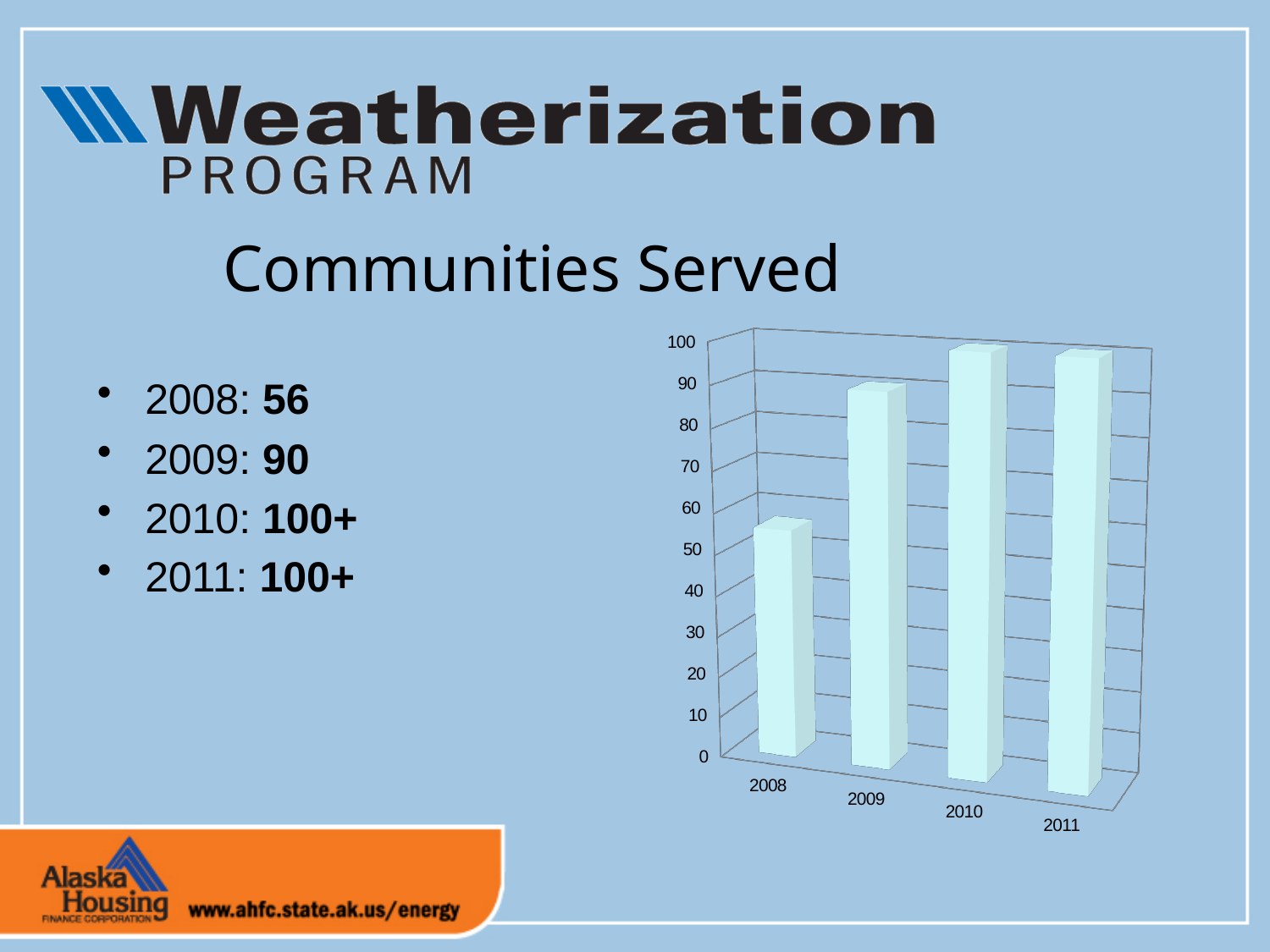
What kind of chart is shown on the slide? bar chart Is the value for 2011 greater or less than 90? greater Is the value for 2008 greater or less than 60? less How many years are plotted on the chart? 4 Which year has the lowest bar on the chart? 2008 Do the values generally rise or fall from 2008 to 2011? rise What is the difference between the values for 2009 and 2008? 34 What is the number of communities served in 2009? 90 What is the number of communities served in 2008? 56 Which is larger, the value for 2008 or the value for 2009? 2009 Is the value for 2009 greater or less than 80? greater